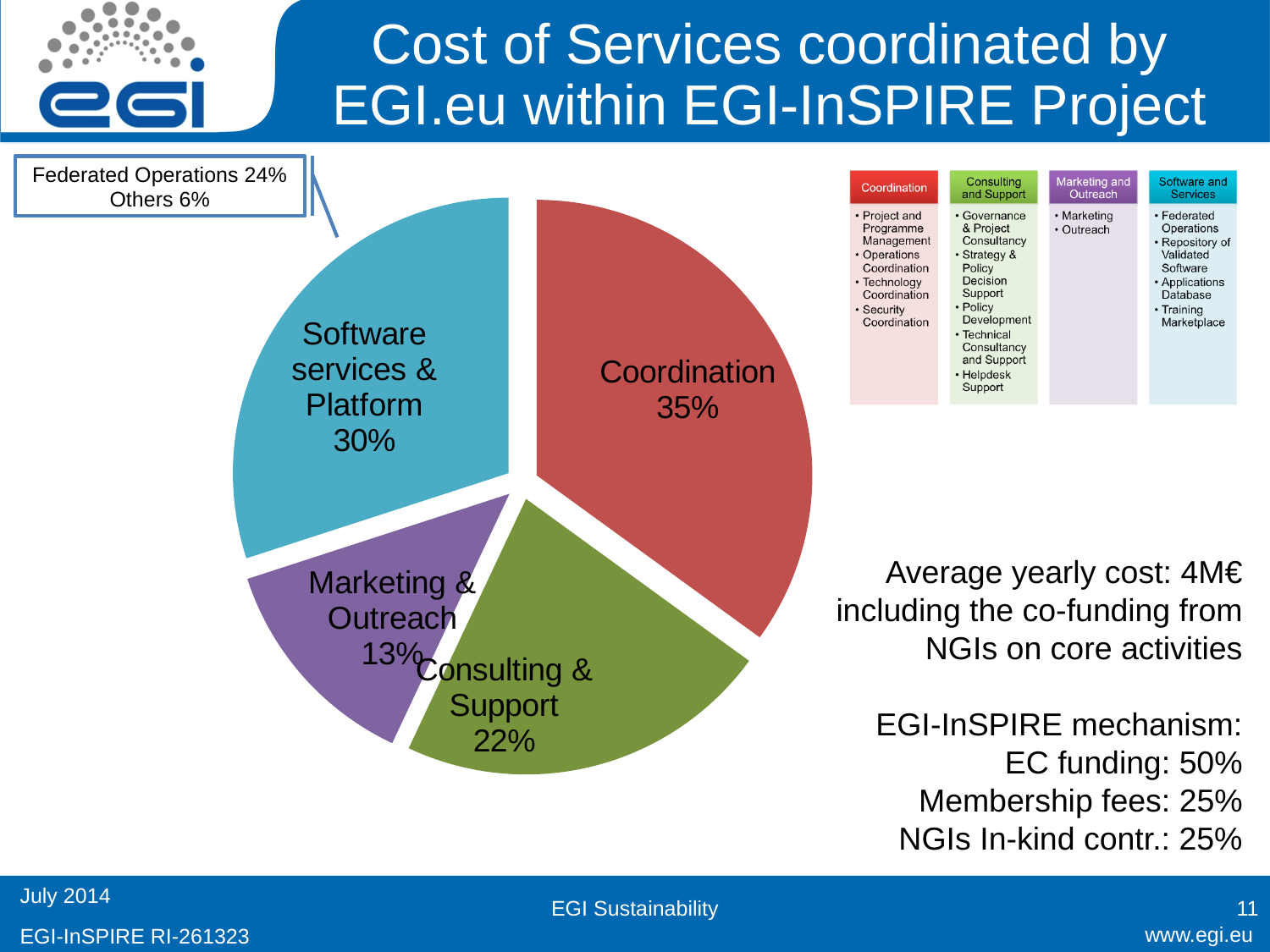
How many slices does the pie chart have? 4 What is the difference in percentage points between Coordination and Consulting & Support? 13 Which is larger, the share for Software services & Platform or the share for Consulting & Support? Software services & Platform What share of the cost does Consulting & Support account for? 22% Which service category has the largest share of the pie? Coordination What colour is the Coordination slice of the pie chart? red What kind of chart is shown on the slide? pie chart Which service category has the smallest share of the pie? Marketing & Outreach What share of the cost does Marketing & Outreach account for? 13% What share of the cost does Coordination account for? 35% According to the callout on the pie chart, what share is attributed to Federated Operations? 24% What share of the cost does Software services & Platform account for? 30%